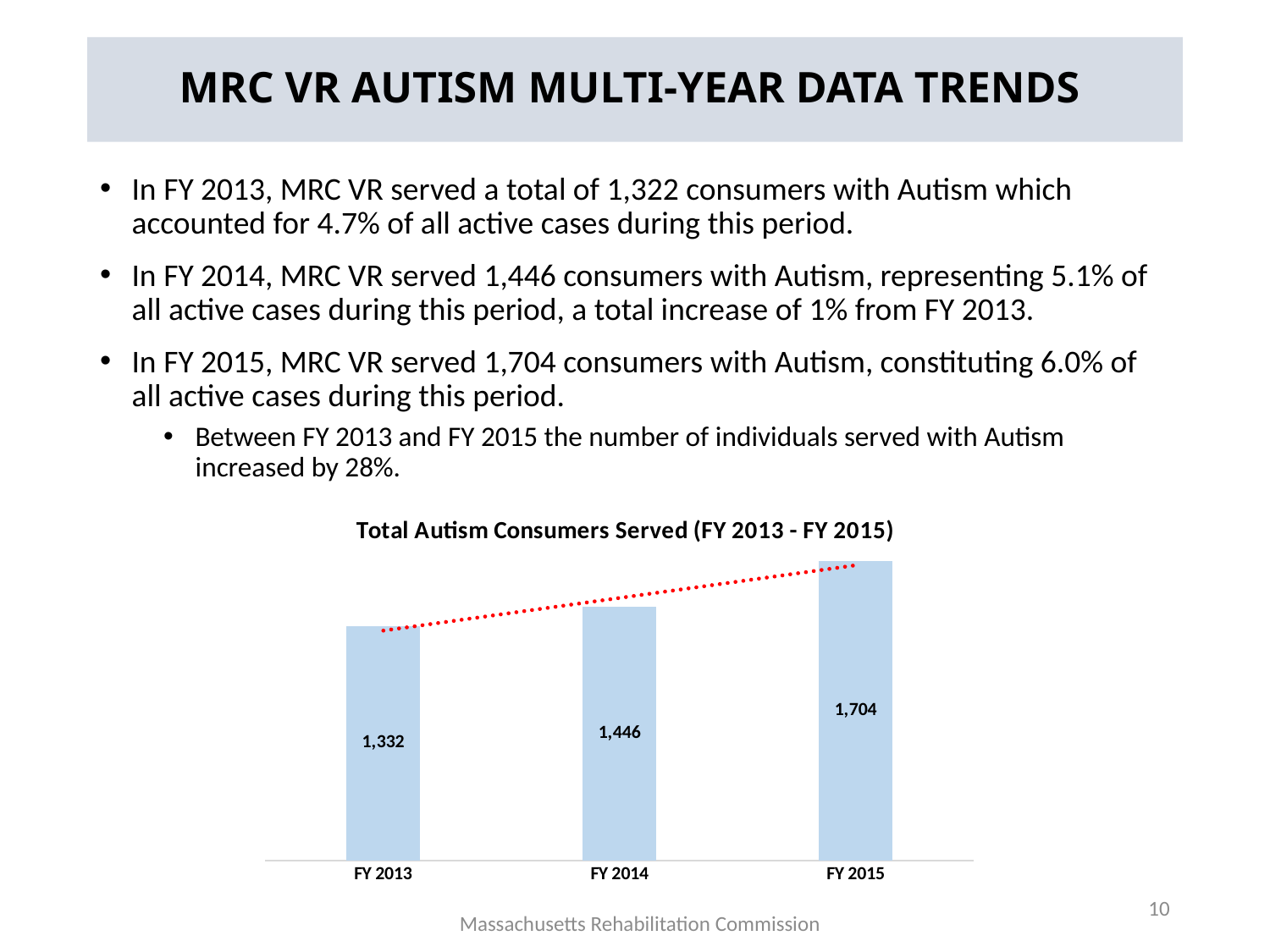
Which fiscal year has the highest number of autism consumers served? FY 2015 What is the value for FY 2014 in the chart? 1,446 What is the difference between the values for FY 2014 and FY 2013? 114 How many fiscal years are shown in the chart? 3 What is the title of the chart? Total Autism Consumers Served (FY 2013 - FY 2015) Which is larger, the value for FY 2014 or the value for FY 2015? FY 2015 Do the values rise or fall from FY 2013 to FY 2015? Rise What kind of chart is shown on the slide? Bar chart Which fiscal year has the lowest number of autism consumers served? FY 2013 What is the value for FY 2015 in the chart? 1,704 What is the value for FY 2013 in the chart? 1,332 What is the difference between the values for FY 2015 and FY 2014? 258